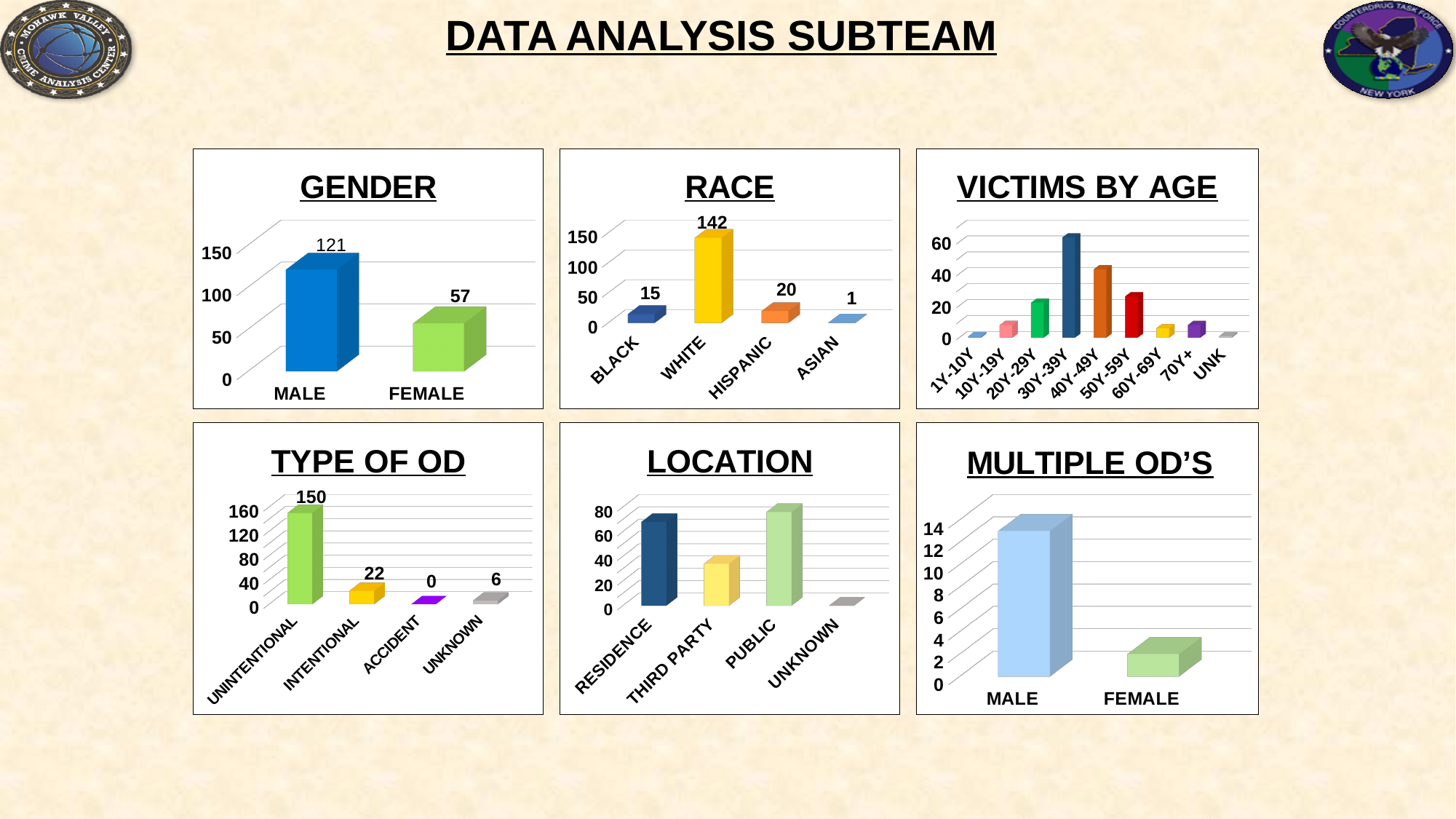
In the RACE chart, what is the value for HISPANIC? 20 In the TYPE OF OD chart, what is the value for INTENTIONAL? 22 In the TYPE OF OD chart, which is larger, UNINTENTIONAL or UNKNOWN? UNINTENTIONAL In the MULTIPLE OD'S chart, is the value for MALE greater or less than 10? greater In the GENDER chart, what is the value for MALE? 121 In the GENDER chart, what is the difference between the MALE and FEMALE values? 64 In the VICTIMS BY AGE chart, which age group has the highest value? 30Y-39Y In the VICTIMS BY AGE chart, is the value for 10Y-19Y greater or less than 20? less In the RACE chart, which category has the highest value? WHITE In the VICTIMS BY AGE chart, how many age categories are shown? 9 In the LOCATION chart, is the value for THIRD PARTY greater or less than 40? less In the RACE chart, which category has the lowest value? ASIAN